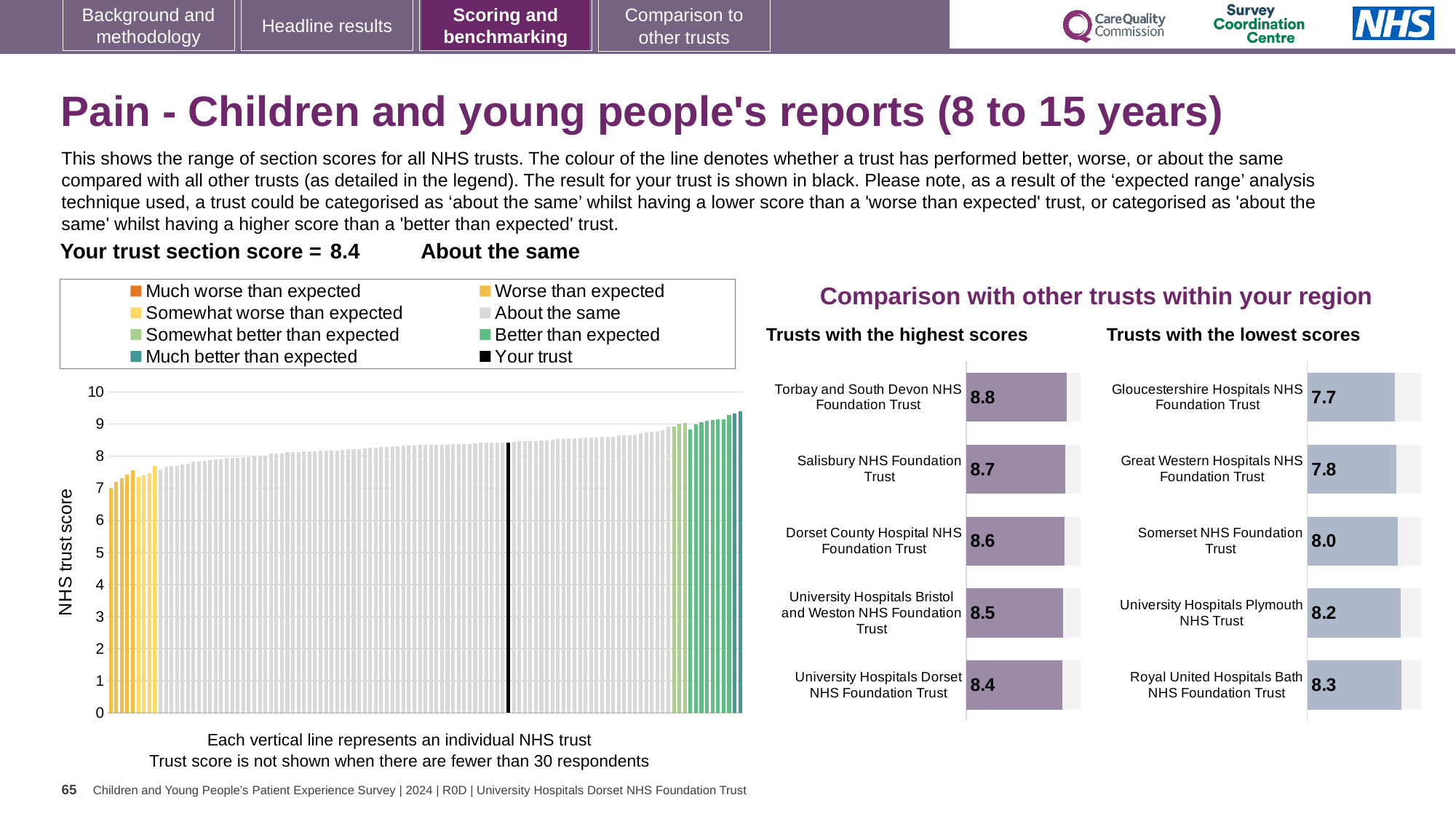
In the 'Trusts with the highest scores' chart, what is the difference between the scores of Torbay and South Devon NHS Foundation Trust and University Hospitals Dorset NHS Foundation Trust? 0.4 In the 'Trusts with the highest scores' chart, what is the score for Torbay and South Devon NHS Foundation Trust? 8.8 In the 'Trusts with the lowest scores' chart, what is the score for University Hospitals Plymouth NHS Trust? 8.2 In the 'Trusts with the lowest scores' chart, what is the difference between the scores of Royal United Hospitals Bath NHS Foundation Trust and Gloucestershire Hospitals NHS Foundation Trust? 0.6 How many trusts are shown in the 'Trusts with the highest scores' chart? 5 In the 'Trusts with the highest scores' chart, what is the score for Dorset County Hospital NHS Foundation Trust? 8.6 What kind of chart is the large chart on the left showing the range of NHS trust scores? Bar chart In the 'Trusts with the lowest scores' chart, which has the larger score: Somerset NHS Foundation Trust or Great Western Hospitals NHS Foundation Trust? Somerset NHS Foundation Trust In the 'Trusts with the lowest scores' chart, which trust has the lowest score? Gloucestershire Hospitals NHS Foundation Trust In the 'Trusts with the lowest scores' chart, what is the score for Gloucestershire Hospitals NHS Foundation Trust? 7.7 In the 'Trusts with the highest scores' chart, which trust has the highest score? Torbay and South Devon NHS Foundation Trust In the large chart on the left showing the range of section scores, is the value for the black 'Your trust' line greater or less than 8? greater